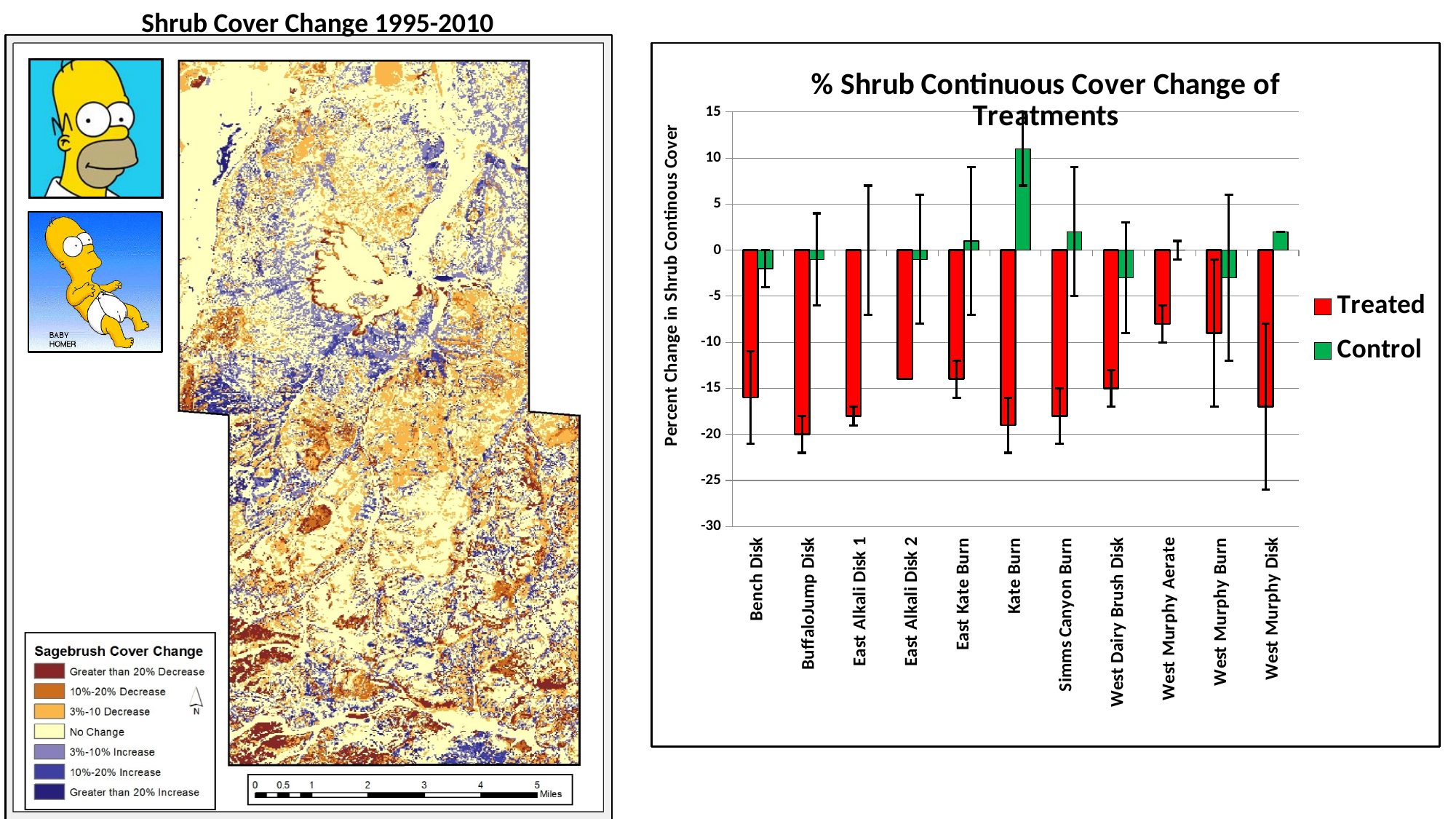
Which category has the highest Control value in the '% Shrub Continuous Cover Change of Treatments' chart? Kate Burn What is the y-axis title of the '% Shrub Continuous Cover Change of Treatments' chart? Percent Change in Shrub Continous Cover Which is larger, the Control value for Kate Burn or the Control value for Bench Disk? Kate Burn Is the Treated value for Bench Disk greater or less than -10? less Is the Control value for Kate Burn greater or less than 5? greater What colour represents the Treated series in the '% Shrub Continuous Cover Change of Treatments' chart? red What kind of chart is shown on the right side of the slide? bar chart How many series does the legend of the '% Shrub Continuous Cover Change of Treatments' chart list? 2 Which is larger, the Treated value for Bench Disk or the Treated value for West Murphy Aerate? West Murphy Aerate How many treatment categories are shown on the x axis of the '% Shrub Continuous Cover Change of Treatments' chart? 11 Is the Treated value for West Murphy Aerate greater or less than -10? greater